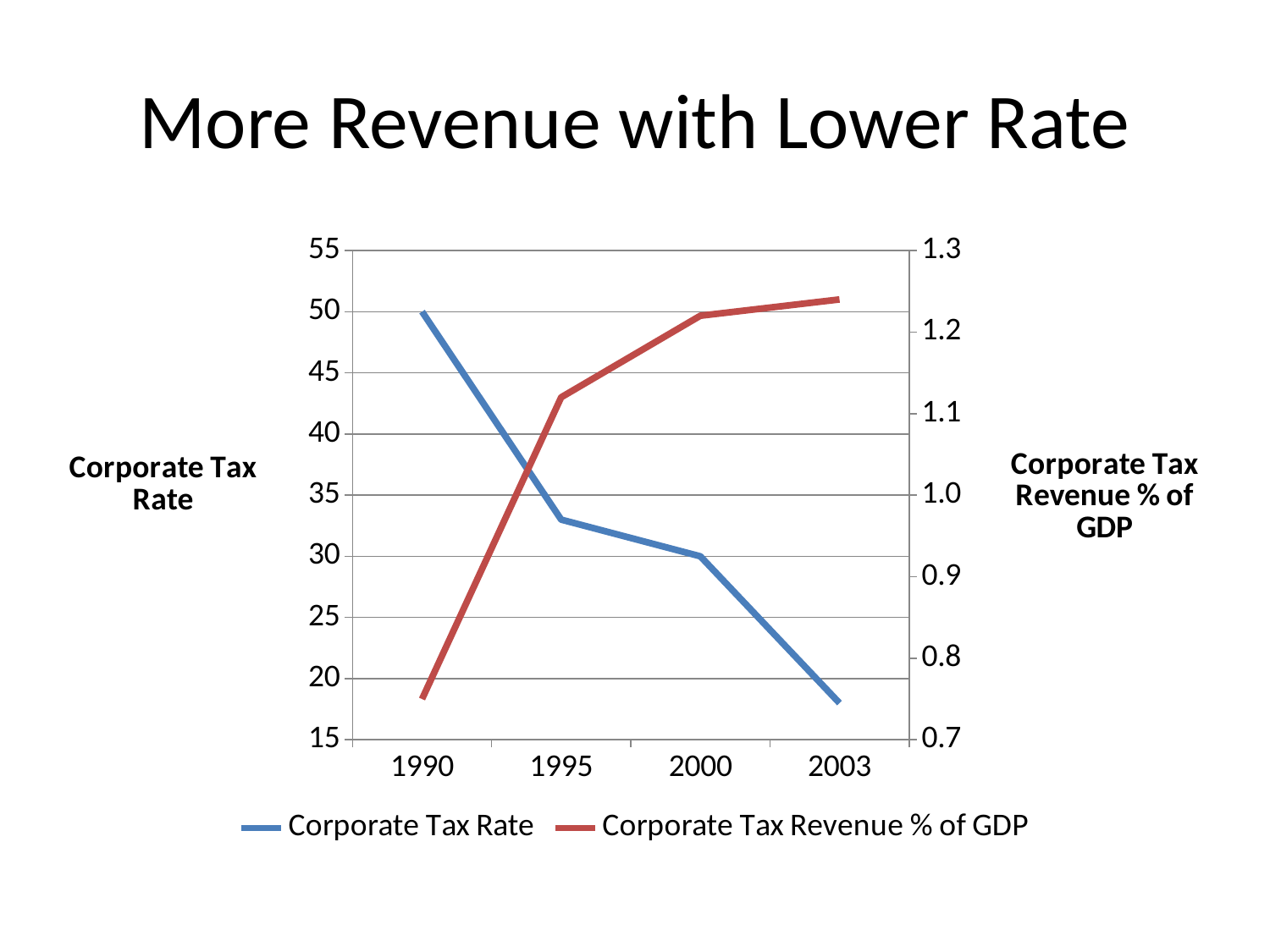
Is the Corporate Tax Rate for 1995 greater or less than 35? less Does the Corporate Tax Revenue % of GDP line rise or fall from 1990 to 2003? rise What kind of chart is shown on the slide? line chart How many series does the legend list? 2 Does the Corporate Tax Rate line rise or fall from 1990 to 2003? fall Is the Corporate Tax Revenue % of GDP for 1990 greater or less than 0.8? less In which year is the Corporate Tax Rate lowest? 2003 Which year has the larger Corporate Tax Rate, 1990 or 2003? 1990 In which year is the Corporate Tax Rate highest? 1990 How many years are plotted along the x axis? 4 In which year is Corporate Tax Revenue % of GDP lowest? 1990 What is the title of the slide containing the chart? More Revenue with Lower Rate